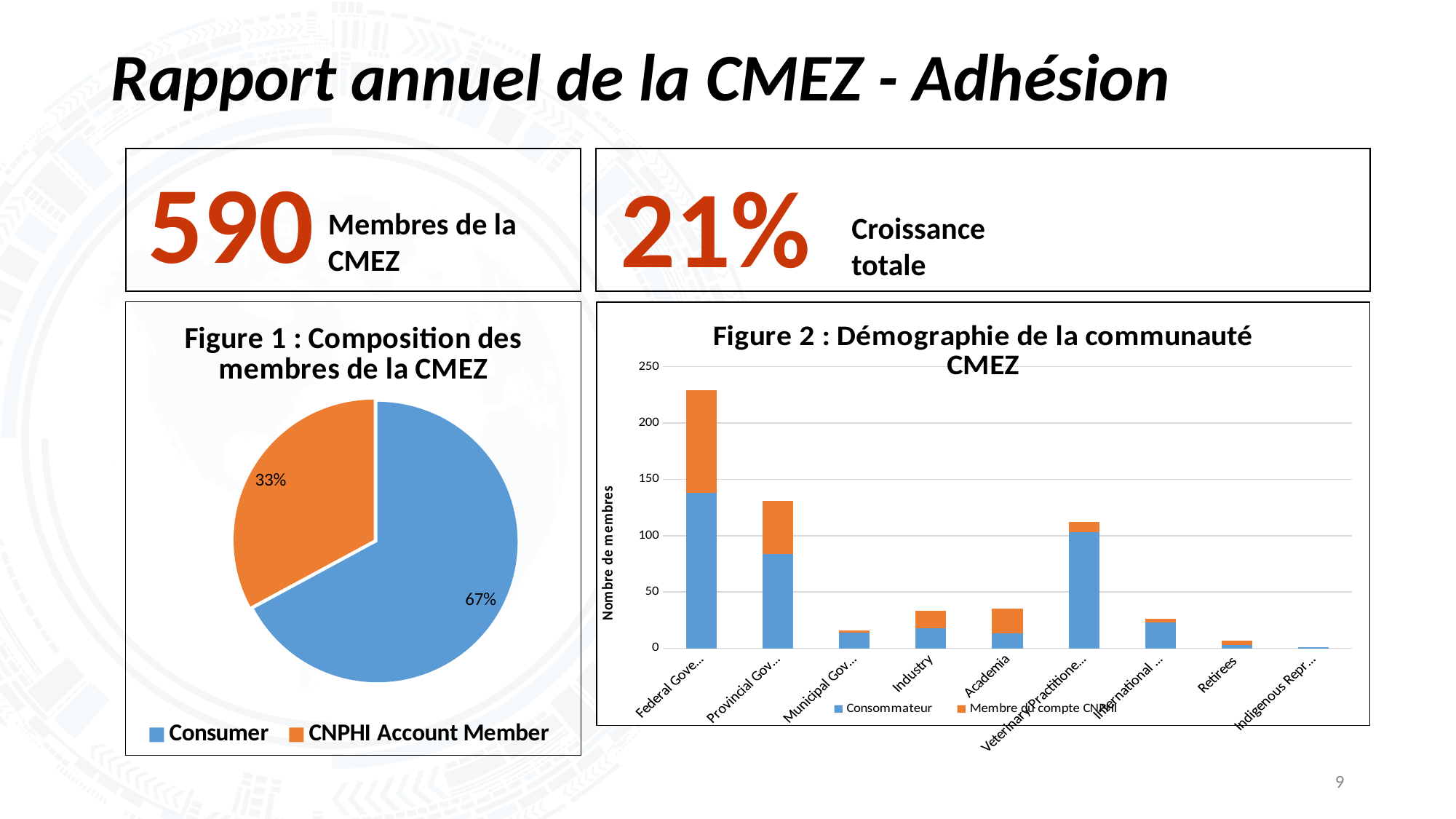
How many categories are shown on the x axis of Figure 2? 9 What kind of chart is Figure 1 : Composition des membres de la CMEZ? pie chart In Figure 1, which slice is larger, Consumer or CNPHI Account Member? Consumer What is the y-axis label of Figure 2? Nombre de membres In Figure 2, which category has the shortest stacked bar? Indigenous Repr ... How many series does the legend of Figure 2 list? 2 In Figure 1, what share of the pie is Consumer? 67% What kind of chart is Figure 2 : Démographie de la communauté CMEZ? bar chart In Figure 1, what share of the pie is CNPHI Account Member? 33% In Figure 2, is the total stacked value for Federal Gove... greater or less than 200? greater In Figure 1, by how many percentage points does the Consumer share exceed the CNPHI Account Member share? 34 percentage points In Figure 2, which category has the tallest stacked bar? Federal Gove...